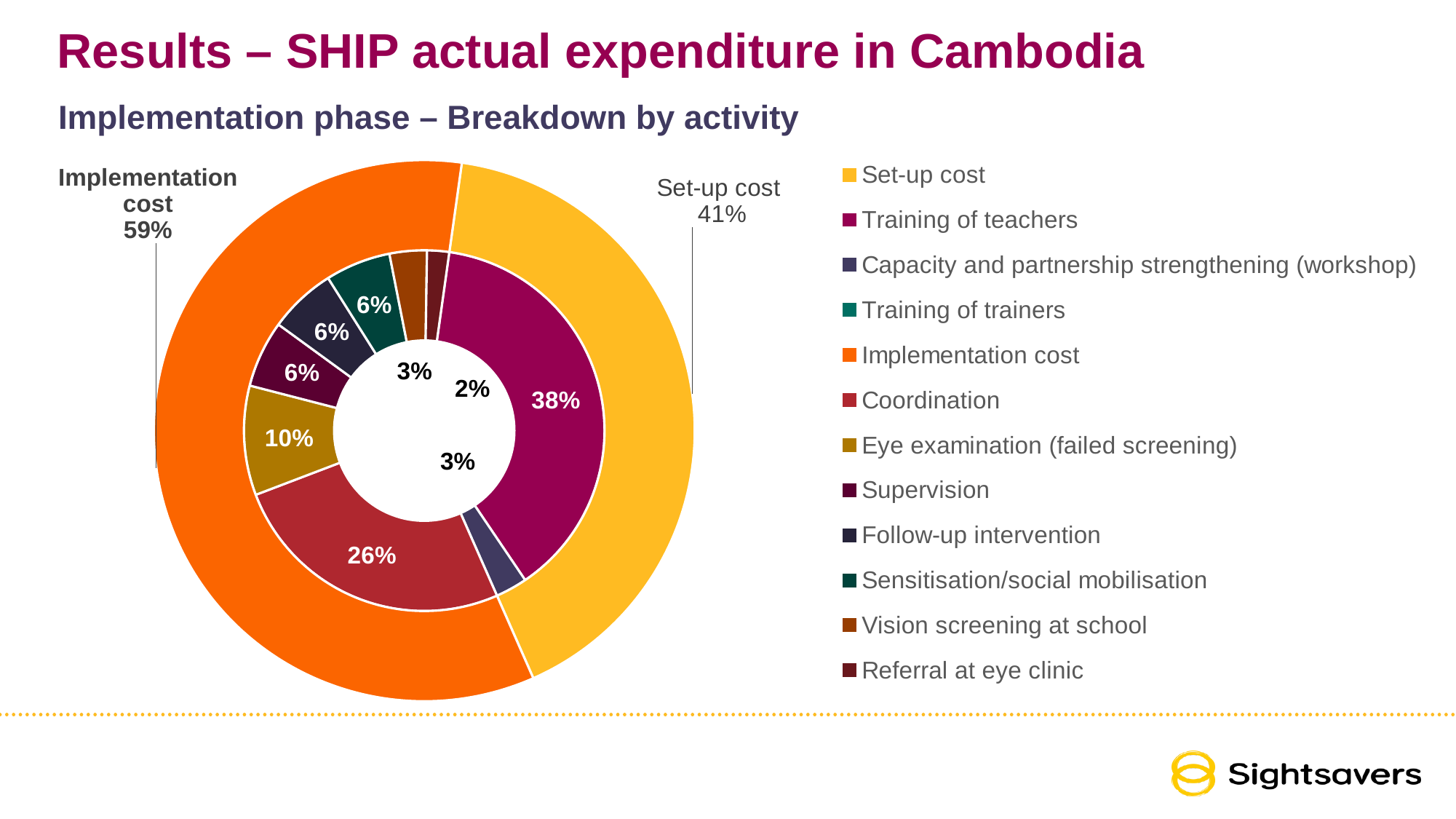
What type of chart is shown on the slide? Doughnut chart How many entries does the legend list? 12 What share of expenditure is Implementation cost in the outer ring? 59% What percentage is shown for Eye examination (failed screening)? 10% What share of expenditure is Set-up cost in the outer ring? 41% What percentage is shown for Coordination? 26% What percentage is shown for Training of teachers? 38% What is the difference in percentage points between Implementation cost and Set-up cost? 18 What colour represents Implementation cost in the chart? Orange Which is larger, Coordination or Eye examination (failed screening)? Coordination Which activity in the inner ring has the largest share? Training of teachers Which activity in the inner ring has the smallest share? Referral at eye clinic